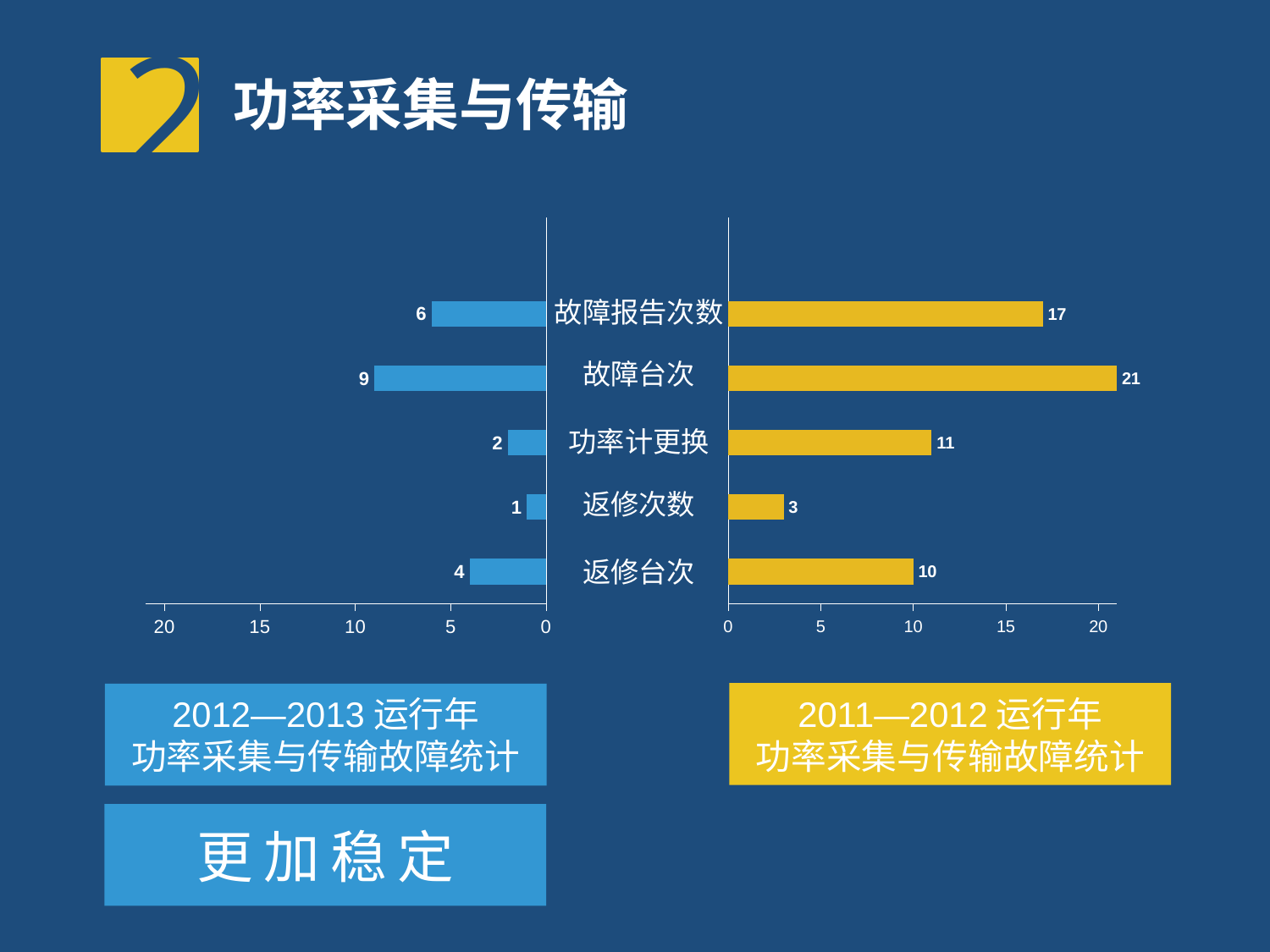
How many categories are shown in the left (blue) chart for 2012—2013 运行年? 5 What colour are the bars in the chart for 2012—2013 运行年? blue In the left (blue) chart for 2012—2013 运行年, which category has the lowest value? 返修次数 Which is larger: 返修台次 in the left (2012—2013) chart or 返修台次 in the right (2011—2012) chart? 返修台次 in the right (2011—2012) chart In the right (yellow) chart for 2011—2012 运行年, which category has the lowest value? 返修次数 In the left (blue) chart for 2012—2013 运行年, which category has the highest value? 故障台次 In the right (yellow) chart for 2011—2012 运行年, what is the value for 功率计更换? 11 What is the difference between the 故障台次 value in the right (2011—2012) chart and the 故障台次 value in the left (2012—2013) chart? 12 In the right (yellow) chart for 2011—2012 运行年, what is the difference between 故障报告次数 and 返修台次? 7 In the right (yellow) chart for 2011—2012 运行年, what is the value for 故障报告次数? 17 In the left (blue) chart for 2012—2013 运行年, what is the value for 故障台次? 9 What kind of chart is the right (yellow) chart for 2011—2012 运行年? bar chart